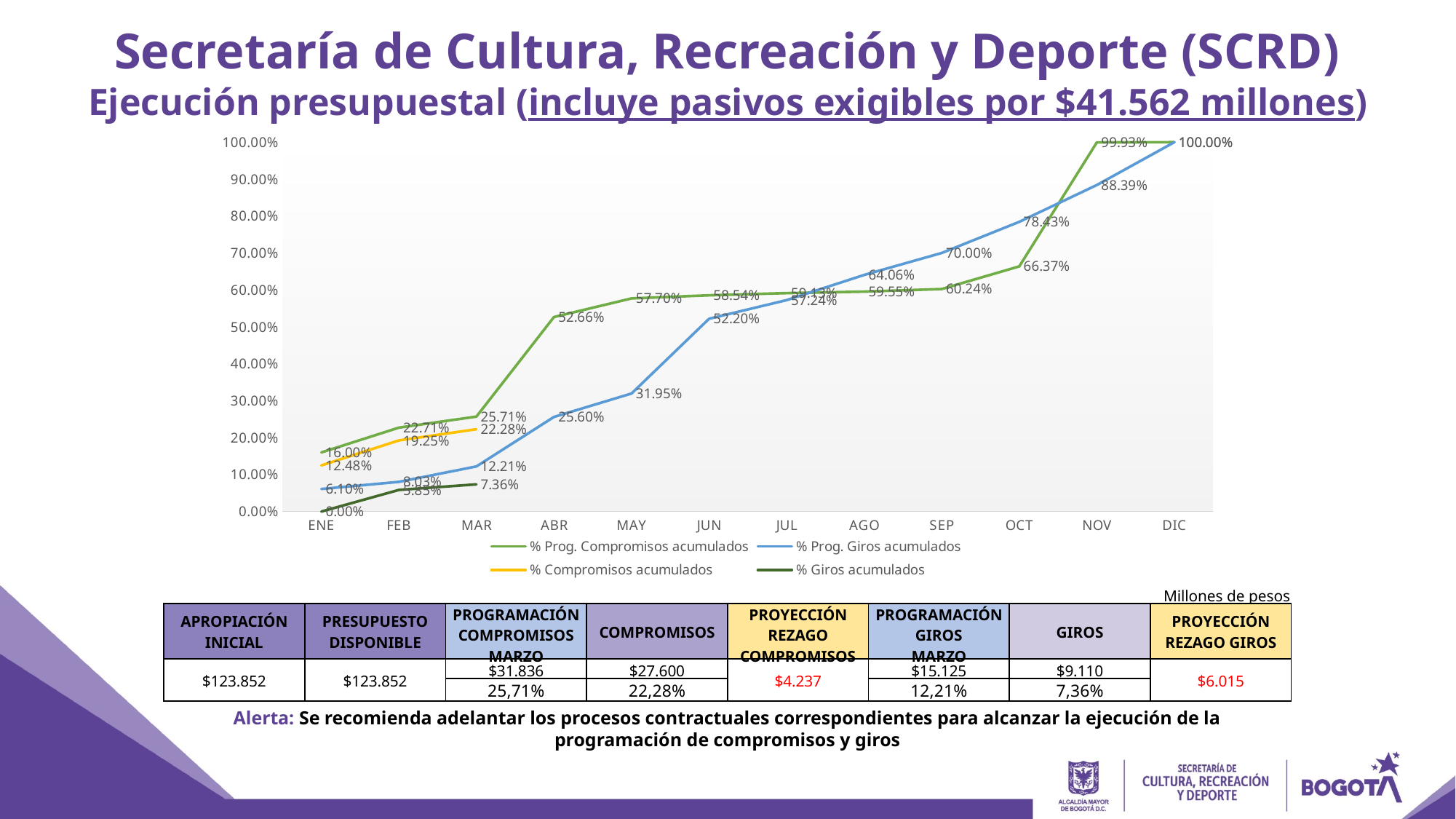
In which month is % Prog. Giros acumulados lowest? ENE Which is larger in MAR: % Prog. Compromisos acumulados or % Prog. Giros acumulados? % Prog. Compromisos acumulados Does % Prog. Giros acumulados rise or fall from ENE to DIC? rise What is the value of % Prog. Compromisos acumulados in ABR? 52.66% What kind of chart is shown on the slide? line chart How many series does the chart legend list? 4 Which colour is used for the % Compromisos acumulados line? yellow What is the value of % Giros acumulados in FEB? 5.85% How many months are shown on the x axis of the chart? 12 What is the difference between % Prog. Compromisos acumulados and % Prog. Giros acumulados in OCT? 12.06% What is the value of % Prog. Giros acumulados in MAY? 31.95% What is the value of % Compromisos acumulados in MAR? 22.28%